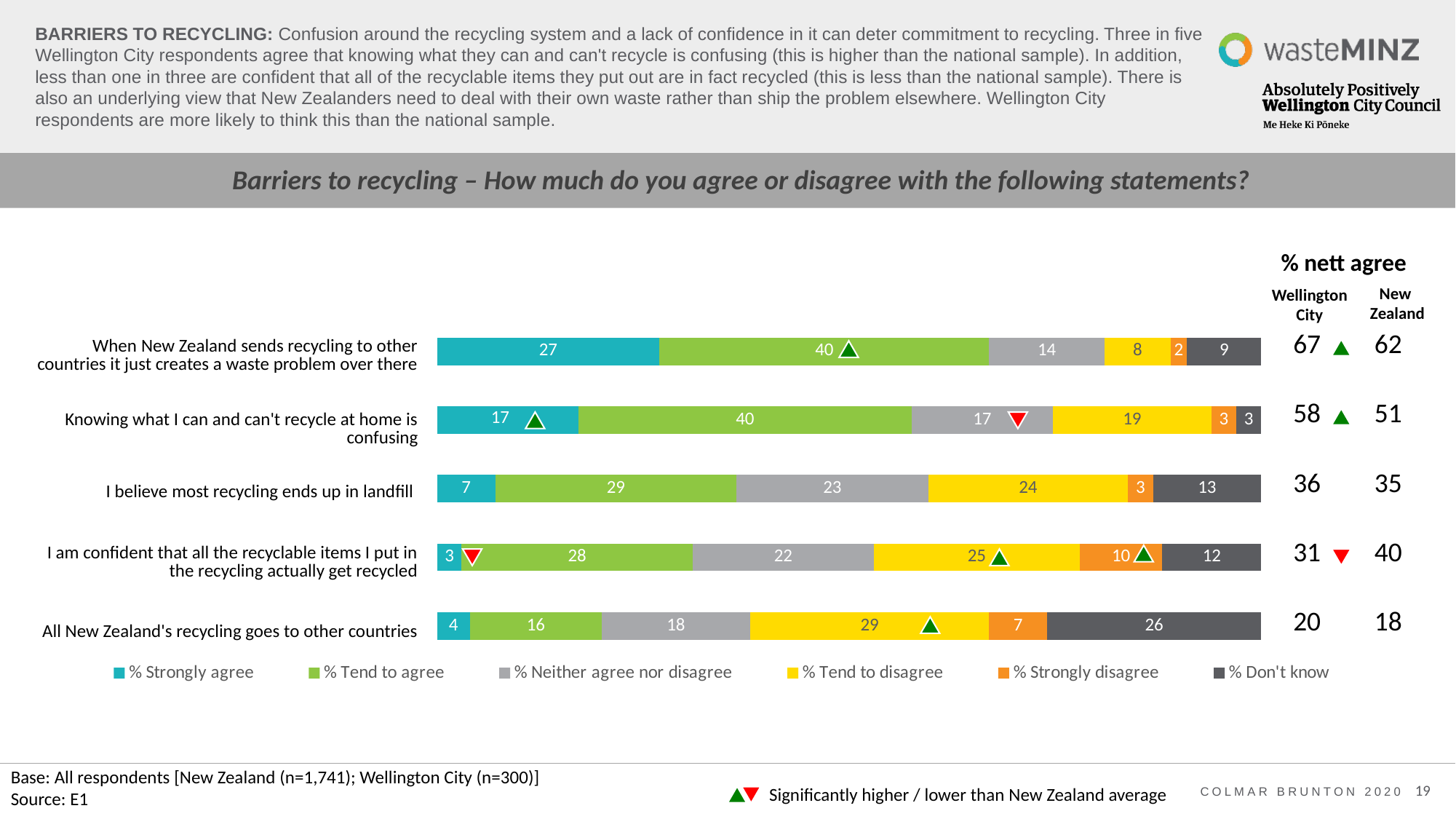
How many statements are shown in the chart? 5 Which statement has the highest "% Strongly agree" value? When New Zealand sends recycling to other countries it just creates a waste problem over there Which statement has the larger "% Neither agree nor disagree" value: "I believe most recycling ends up in landfill" or "All New Zealand's recycling goes to other countries"? I believe most recycling ends up in landfill What is the title of the chart? Barriers to recycling – How much do you agree or disagree with the following statements? What is the "% Don't know" value for the statement "All New Zealand's recycling goes to other countries"? 26 Which statement has the lowest "% Strongly agree" value? I am confident that all the recyclable items I put in the recycling actually get recycled What is the difference in "% Tend to disagree" between "All New Zealand's recycling goes to other countries" and "I believe most recycling ends up in landfill"? 5 What kind of chart is shown on the slide? Stacked bar chart How many series does the chart legend list? 6 What is the total of the stacked bar for "When New Zealand sends recycling to other countries it just creates a waste problem over there"? 100 What is the "% Strongly agree" value for the statement "When New Zealand sends recycling to other countries it just creates a waste problem over there"? 27 What is the Wellington City "% nett agree" value for "Knowing what I can and can't recycle at home is confusing"? 58